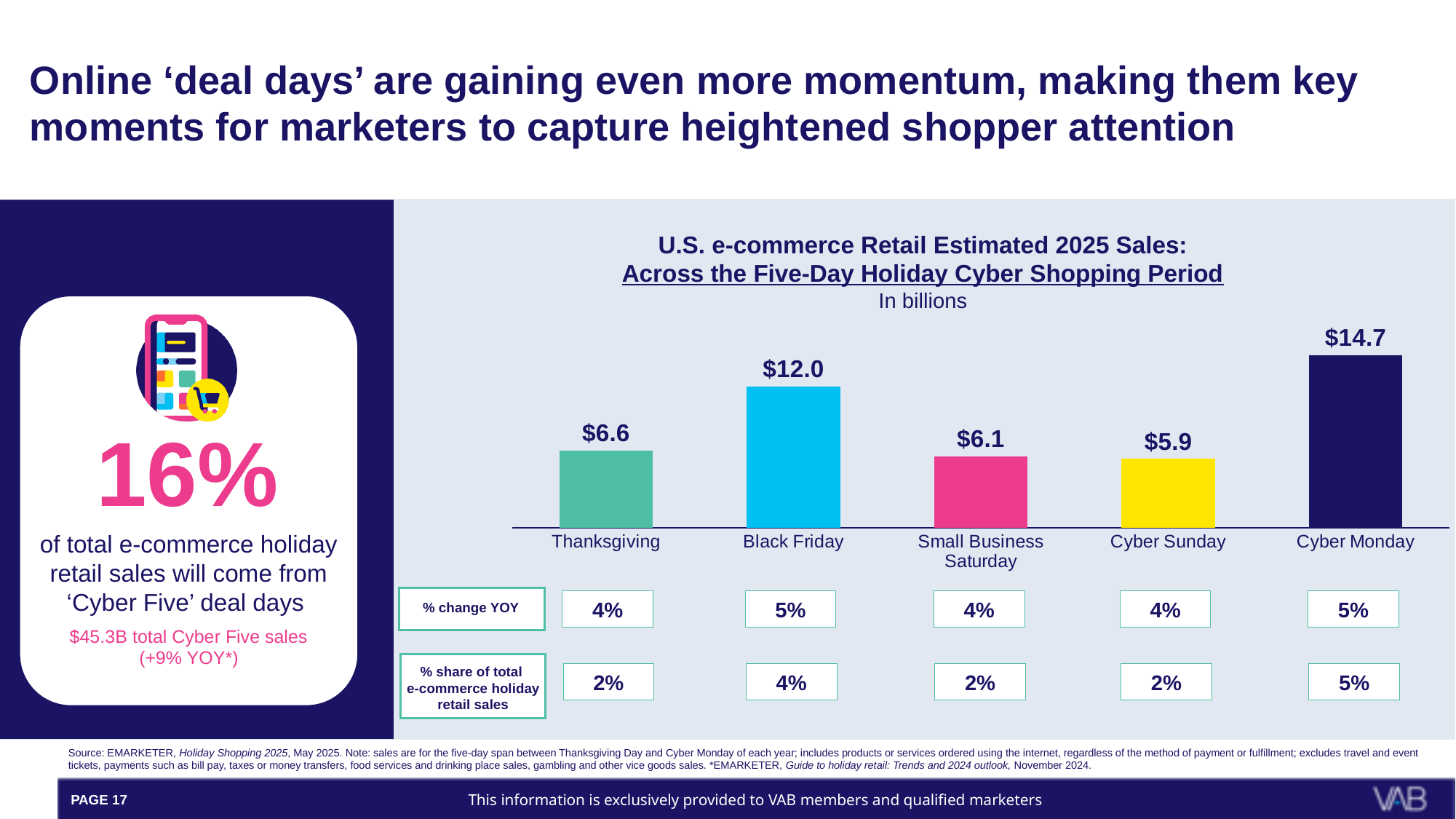
What is the estimated 2025 e-commerce sales value for Cyber Sunday? $5.9 In what units are the chart values expressed? In billions What is the % change YOY shown for Black Friday? 5% What is the % share of total e-commerce holiday retail sales shown for Cyber Monday? 5% What is the estimated 2025 e-commerce sales value for Black Friday? $12.0 What is the difference in estimated sales between Cyber Monday and Black Friday? $2.7 How many days are shown in the chart? 5 Which has higher estimated sales, Thanksgiving or Small Business Saturday? Thanksgiving Which day has the lowest estimated 2025 e-commerce sales? Cyber Sunday What kind of chart is used to show the estimated 2025 sales? Bar chart Which day has the highest estimated 2025 e-commerce sales? Cyber Monday What colour is the Black Friday bar? Light blue